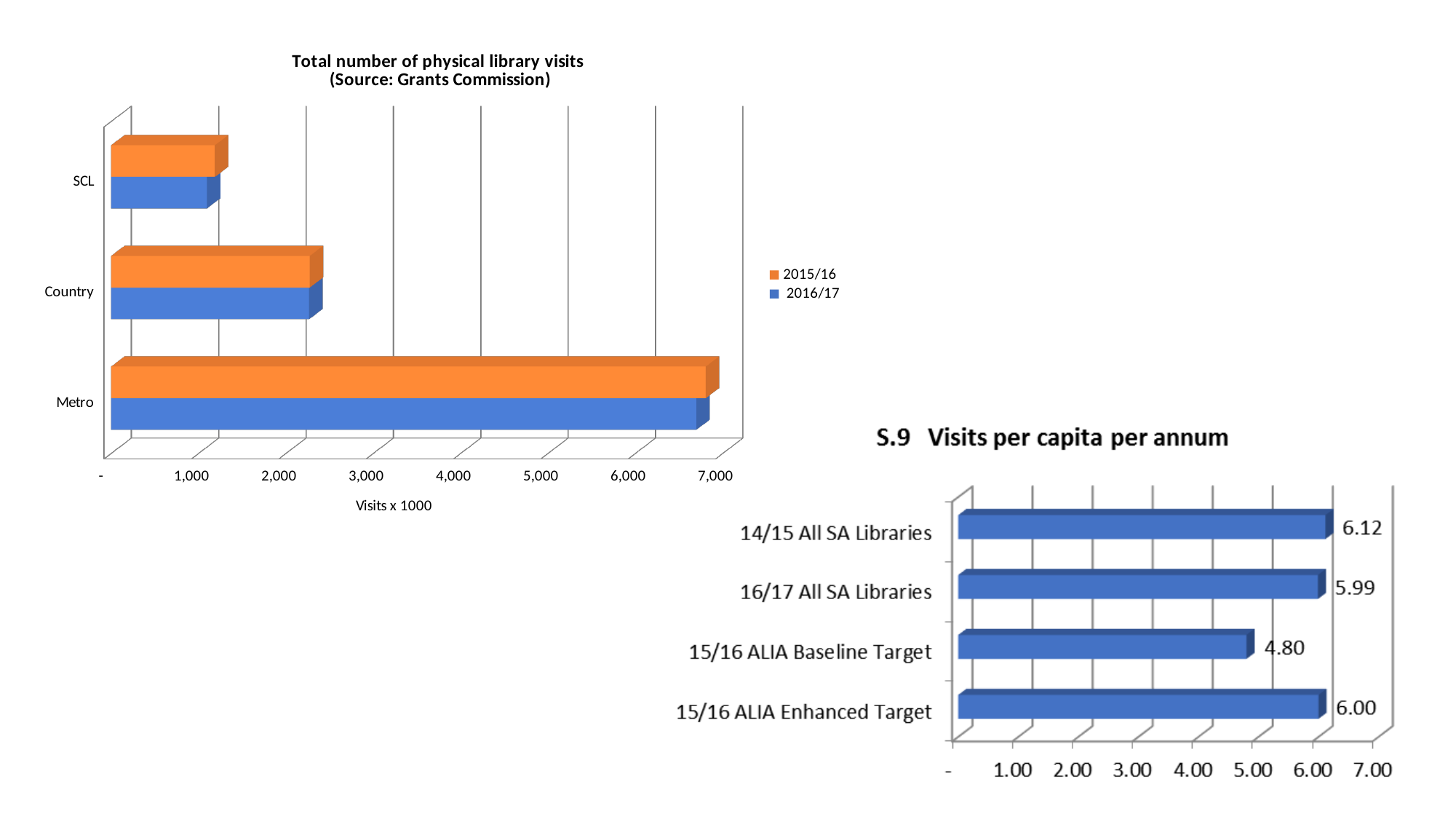
On the 'Visits per capita per annum' chart, what is the difference between the 15/16 ALIA Enhanced Target and the 15/16 ALIA Baseline Target? 1.20 On the 'Visits per capita per annum' chart, which category has the lowest value? 15/16 ALIA Baseline Target On the 'Total number of physical library visits' chart, which category has the highest number of visits? Metro On the 'Visits per capita per annum' chart, which category has the highest value? 14/15 All SA Libraries On the 'Visits per capita per annum' chart, how many categories are shown? 4 On the 'Visits per capita per annum' chart, what is the value for 14/15 All SA Libraries? 6.12 On the 'Visits per capita per annum' chart, what is the difference between 14/15 All SA Libraries and 16/17 All SA Libraries? 0.13 On the 'Total number of physical library visits' chart, is the 2015/16 value for Country greater or less than 3,000? less On the 'Visits per capita per annum' chart, what is the value for 15/16 ALIA Baseline Target? 4.80 On the 'Total number of physical library visits' chart, is the 2015/16 value for Metro greater or less than 6,000? greater What kind of chart is the 'Total number of physical library visits' chart? Bar chart On the 'Total number of physical library visits' chart, how many series does the legend list? 2